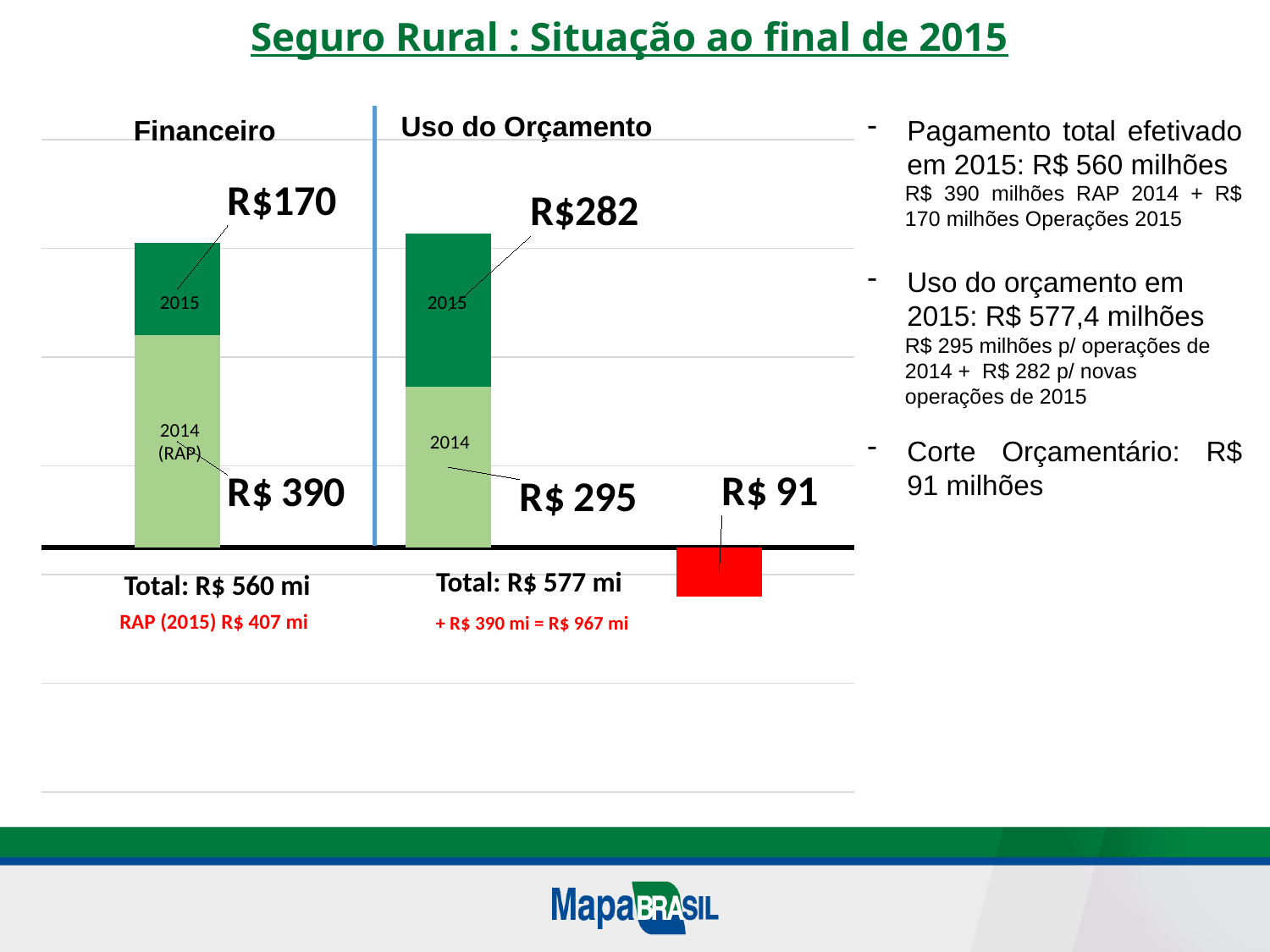
What is the value of the 2014 segment in the Uso do Orçamento bar? R$ 295 What is the total shown for the Financeiro bar? R$ 560 mi What is the difference between the 2014 (RAP) segment of the Financeiro bar and the 2014 segment of the Uso do Orçamento bar? R$ 95 What kind of chart is shown on the slide? Stacked bar chart What is the value of the 2015 segment in the Uso do Orçamento bar? R$282 What is the value of the 2014 (RAP) segment in the Financeiro bar? R$ 390 What is the value shown for the red bar below the axis? R$ 91 What is the value of the 2015 segment in the Financeiro bar? R$170 Which segment is larger in the Financeiro bar, 2014 (RAP) or 2015? 2014 (RAP) What is the title of the slide containing the chart? Seguro Rural : Situação ao final de 2015 What is the total shown for the Uso do Orçamento bar? R$ 577 mi What is the difference between the 2015 segment of the Uso do Orçamento bar and the 2015 segment of the Financeiro bar? R$ 112